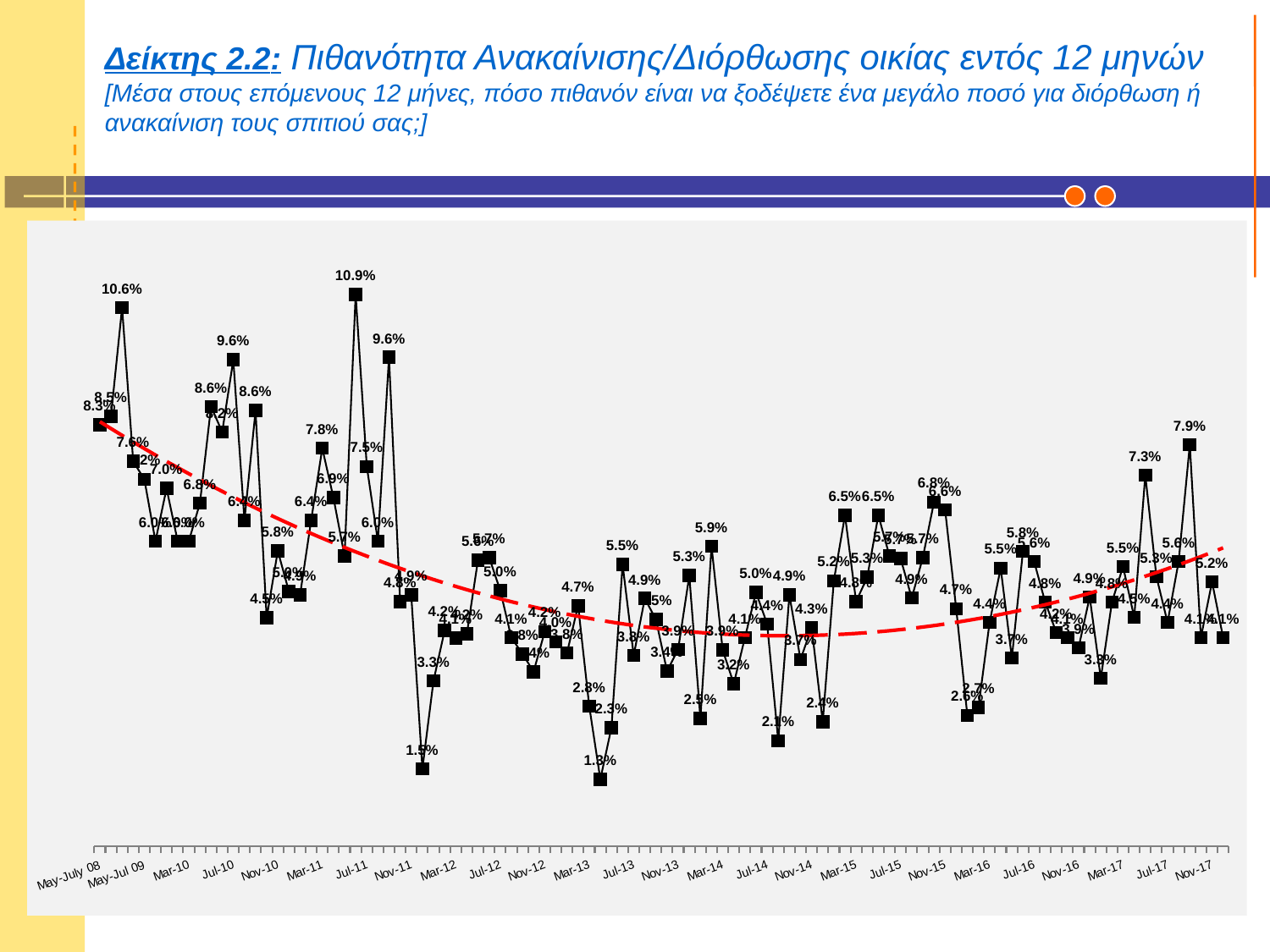
What is the value of the first data point (May-July 08)? 8.3% Which is larger, the first data point (May-July 08) or the last data point (Nov-17)? the first data point (May-July 08) What is the difference between the first data point (8.3%) and the last data point (4.1%)? 4.2% Do the values generally rise or fall from the start of the series in 2008 to early 2013? fall Does the red dashed trend line rise or fall over the final part of the chart (2015 to 2017)? rise What is the value of the last data point on the chart (Nov-17)? 4.1% Which is larger, the peak near the start of the series (10.6%) or the peak around Jul-11 (10.9%)? the peak around Jul-11 (10.9%) What kind of chart is shown on the slide? line chart What is the difference between the highest labeled value (10.9%) and the lowest labeled value (1.3%)? 9.6% What is the lowest value labeled on the chart? 1.3% What is the highest value labeled on the chart? 10.9% What colour is the dashed trend line on the chart? red